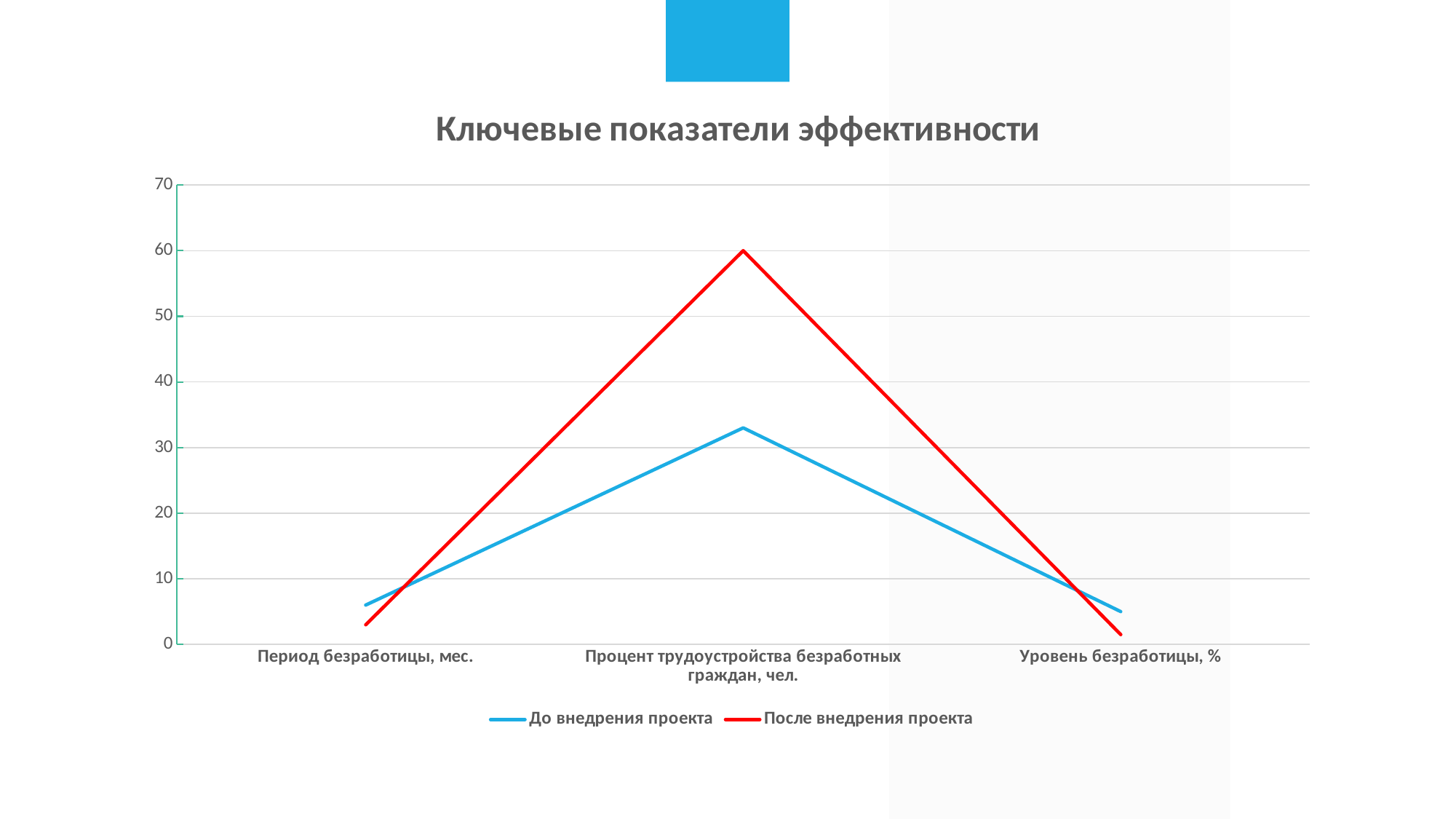
Which series is drawn in red? После внедрения проекта For which category is the 'До внедрения проекта' series highest? Процент трудоустройства безработных граждан, чел. For 'Процент трудоустройства безработных граждан, чел.', which series has the larger value: 'До внедрения проекта' or 'После внедрения проекта'? После внедрения проекта For which category is the 'После внедрения проекта' series highest? Процент трудоустройства безработных граждан, чел. Is the value of 'После внедрения проекта' for 'Уровень безработицы, %' greater or less than 10? less For 'Период безработицы, мес.', which series has the larger value: 'До внедрения проекта' or 'После внедрения проекта'? До внедрения проекта Is the value of 'До внедрения проекта' for 'Процент трудоустройства безработных граждан, чел.' greater or less than 30? greater What kind of chart is shown on the slide? line chart How many series does the legend list? 2 What is the title of the chart? Ключевые показатели эффективности How many categories are shown on the x axis? 3 What is the value of the 'После внедрения проекта' series for 'Процент трудоустройства безработных граждан, чел.'? 60